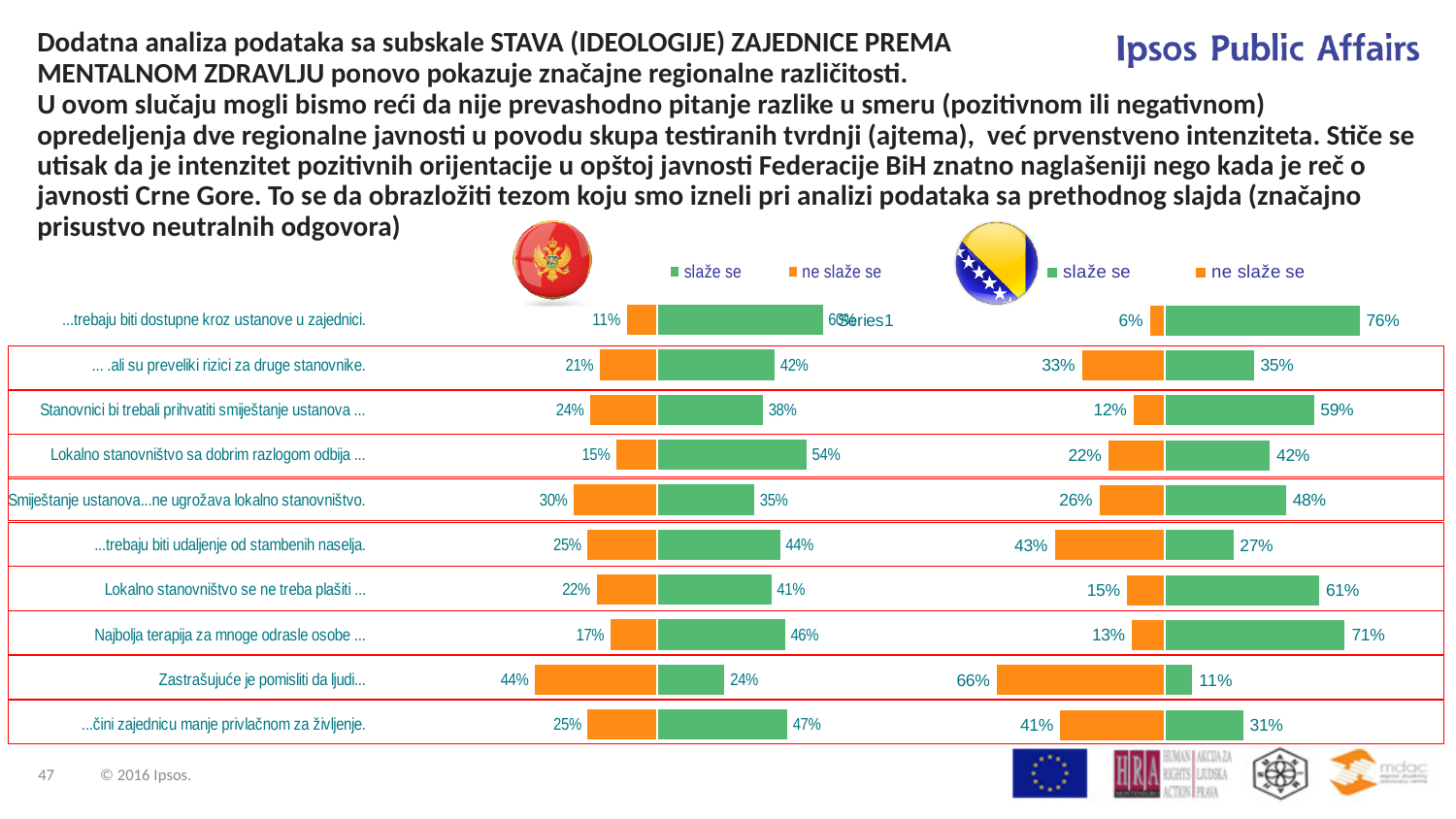
In the left chart, what is the 'ne slaže se' value for 'Zastrašujuće je pomisliti da ljudi...'? 44% How many series does the legend of the right chart list? 2 In the right chart, what is the difference between the 'slaže se' and 'ne slaže se' values for 'Zastrašujuće je pomisliti da ljudi...'? 55% What type of chart is the left chart? bar chart In the right chart, what is the 'ne slaže se' value for '...trebaju biti udaljenje od stambenih naselja.'? 43% In the left chart, which is larger for 'Smještanje ustanova...ne ugrožava lokalno stanovništvo.': 'slaže se' or 'ne slaže se'? slaže se In the right chart, which category has the lowest 'slaže se' value? Zastrašujuće je pomisliti da ljudi... In the right chart, which category has the highest 'slaže se' value? ...trebaju biti dostupne kroz ustanove u zajednici. In the left chart, what is the 'slaže se' value for 'Lokalno stanovništvo sa dobrim razlogom odbija ...'? 54% In the left chart, which category has the highest 'ne slaže se' value? Zastrašujuće je pomisliti da ljudi... In the right chart, what is the 'slaže se' value for 'Najbolja terapija za mnoge odrasle osobe ...'? 71% How many categories does the left chart show? 10